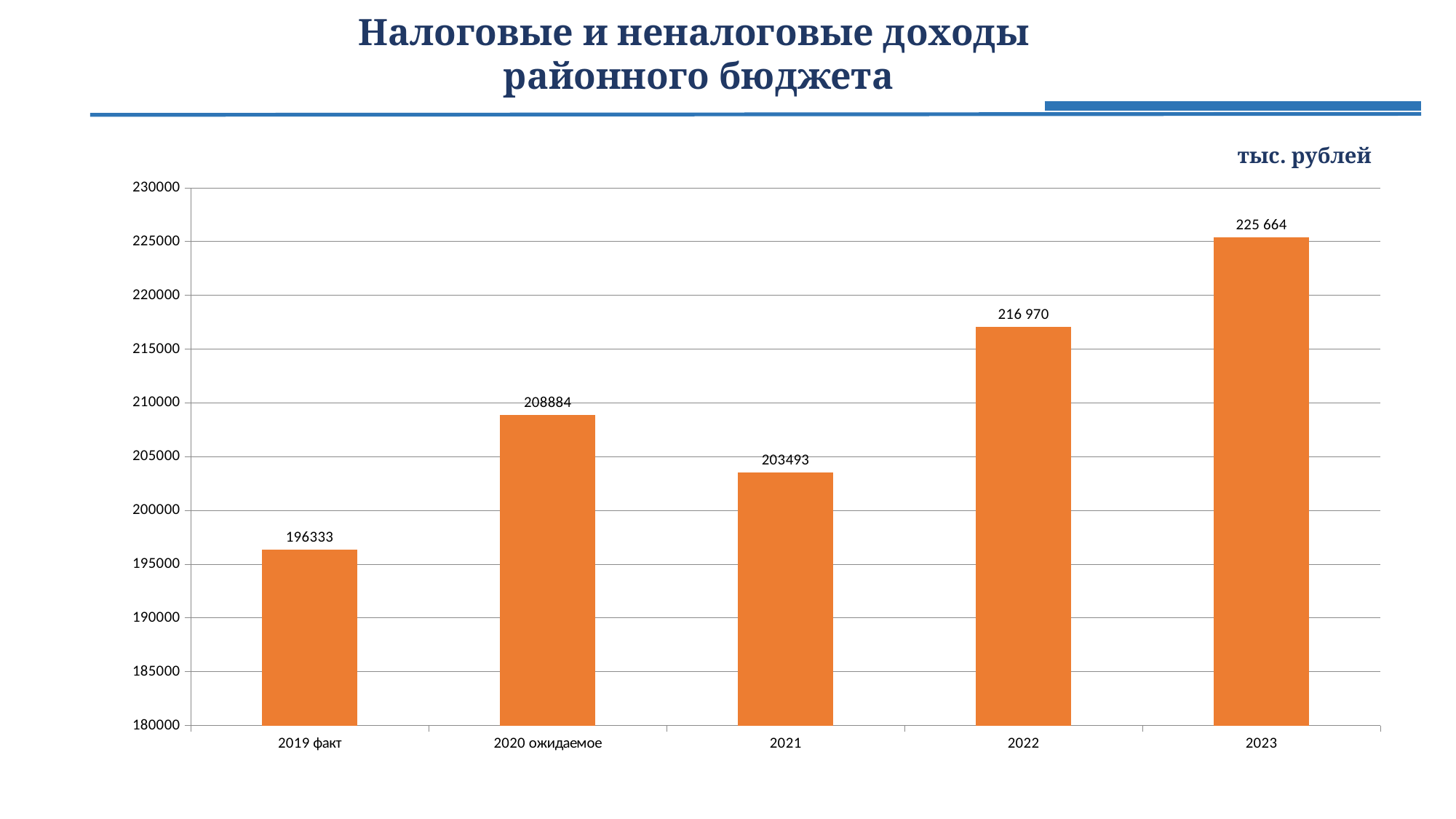
What is the value for 2023? 225 664 What is the value for 2020 ожидаемое? 208884 Does the value rise or fall from 2020 ожидаемое to 2021? fall What is the value for 2019 факт? 196333 How many bars are shown in the chart? 5 Which category has the lowest value? 2019 факт Which is larger, the value for 2020 ожидаемое or the value for 2021? 2020 ожидаемое What unit is indicated above the chart? тыс. рублей What is the difference between the values for 2023 and 2022? 8694 What kind of chart is shown on the slide? bar chart Is the value for 2021 greater or less than 205000? less Which year has the highest value? 2023